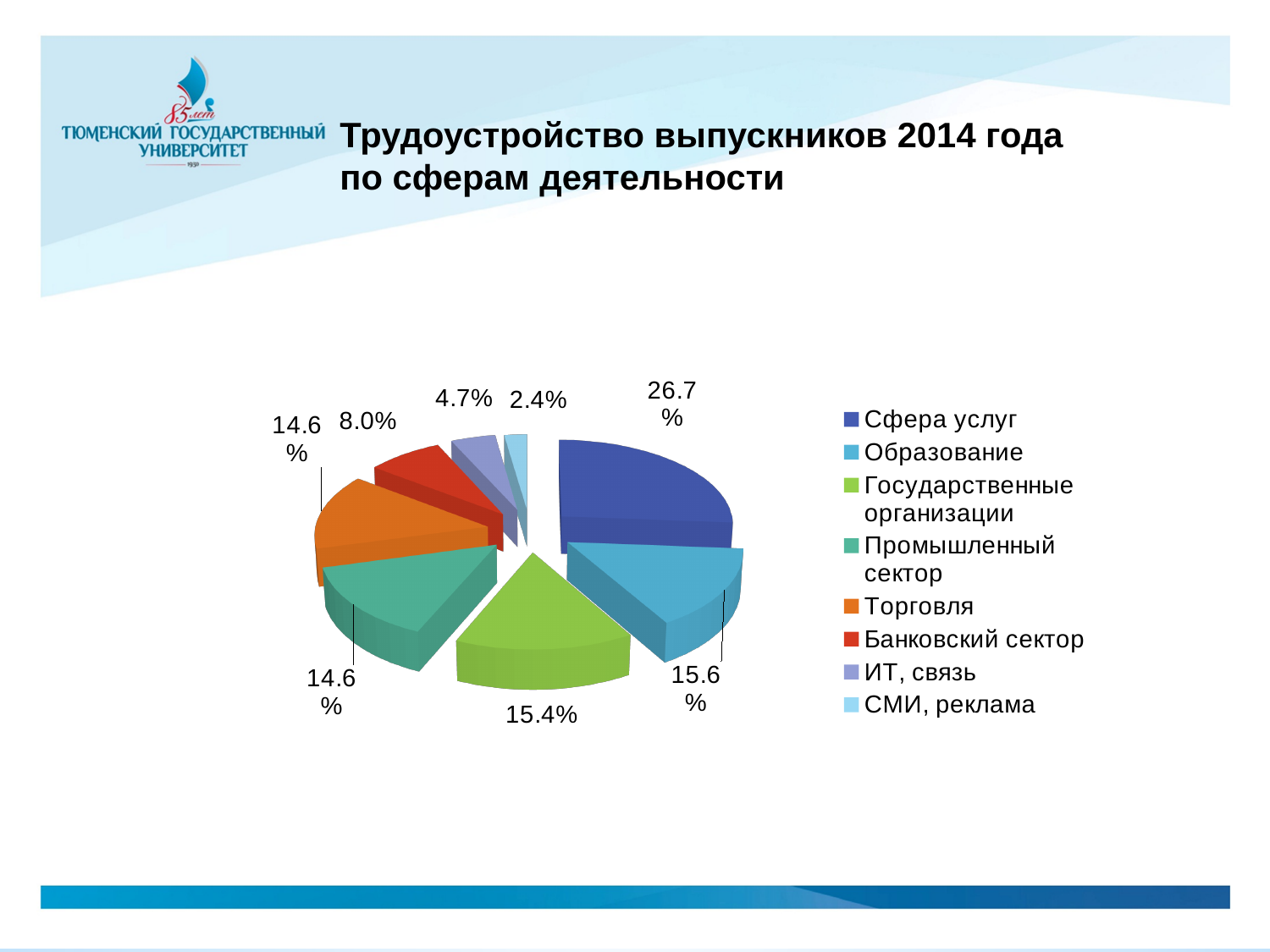
Which is larger, the share of Банковский сектор or the share of ИТ, связь? Банковский сектор What is the value for Государственные организации? 15.4% Which category has the largest share of the pie? Сфера услуг What is the value for Банковский сектор? 8.0% What is the title of the slide? Трудоустройство выпускников 2014 года по сферам деятельности What share of the pie does Сфера услуг have? 26.7% What is the value for СМИ, реклама? 2.4% What type of chart is shown on the slide? pie chart Which category has the smallest share of the pie? СМИ, реклама What is the value for Образование? 15.6% How many categories does the pie chart have? 8 What is the difference between the shares of Сфера услуг and Образование? 11.1 percentage points